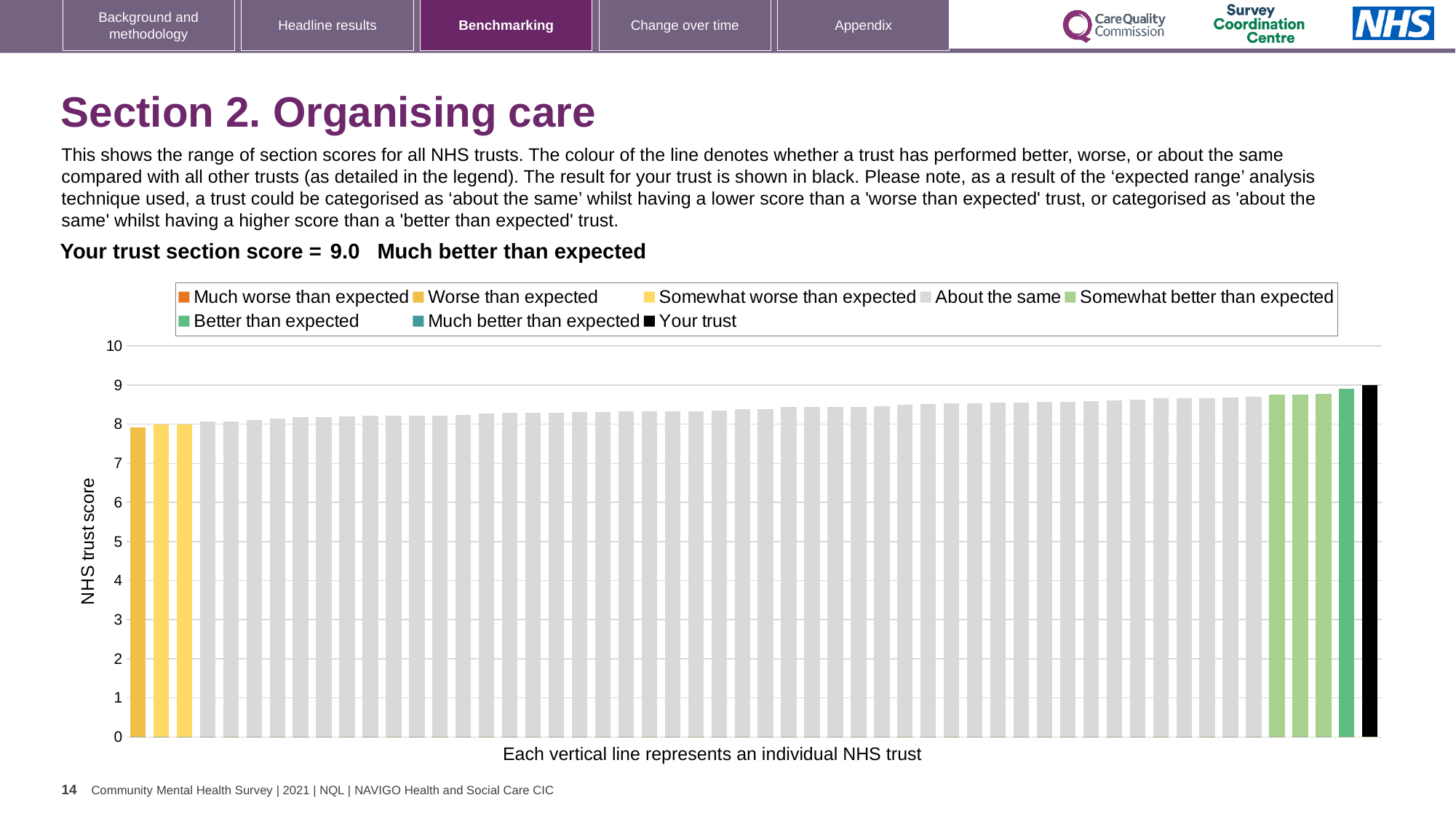
What is the section score for your trust, as printed on the slide? 9.0 How many bars are coloured in the green shades (excluding the black bar)? 4 Is the value of the leftmost bar greater or less than 9? less Is the value of the black 'Your trust' bar greater or less than 8? greater How many bars are coloured in the yellow shades at the left of the chart? 3 How many entries does the chart legend list? 8 Is the value of the leftmost bar greater or less than 7? greater Which bar has the highest value on the chart? Your trust (the black bar) Do the bar values rise or fall from left to right along the x axis? rise What colour does the legend use for 'Your trust'? black What kind of chart is shown on the slide? bar chart What is the label on the vertical axis of the chart? NHS trust score